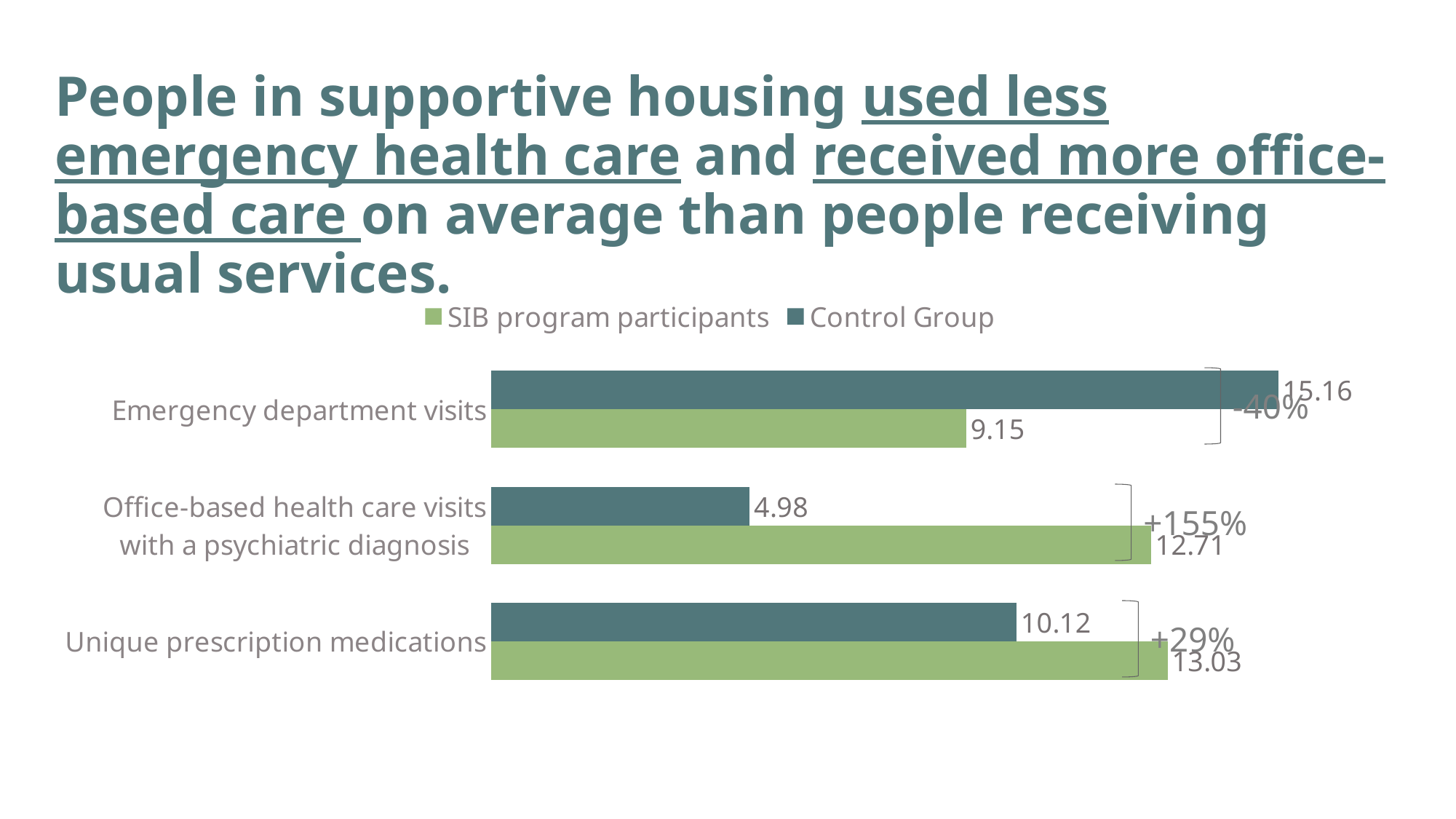
Which category has the highest value for the Control Group? Emergency department visits What is the difference between the Control Group and SIB program participants for Emergency department visits? 6.01 For Office-based health care visits with a psychiatric diagnosis, which group has the larger value? SIB program participants How many categories are shown on the chart? 3 What is the value for SIB program participants for Unique prescription medications? 13.03 What kind of chart is shown on the slide? Bar chart What is the value for the Control Group for Office-based health care visits with a psychiatric diagnosis? 4.98 How many series does the legend list? 2 What is the difference between SIB program participants and the Control Group for Unique prescription medications? 2.91 What is the value for the Control Group for Emergency department visits? 15.16 What is the value for SIB program participants for Emergency department visits? 9.15 Which category has the lowest value for SIB program participants? Emergency department visits